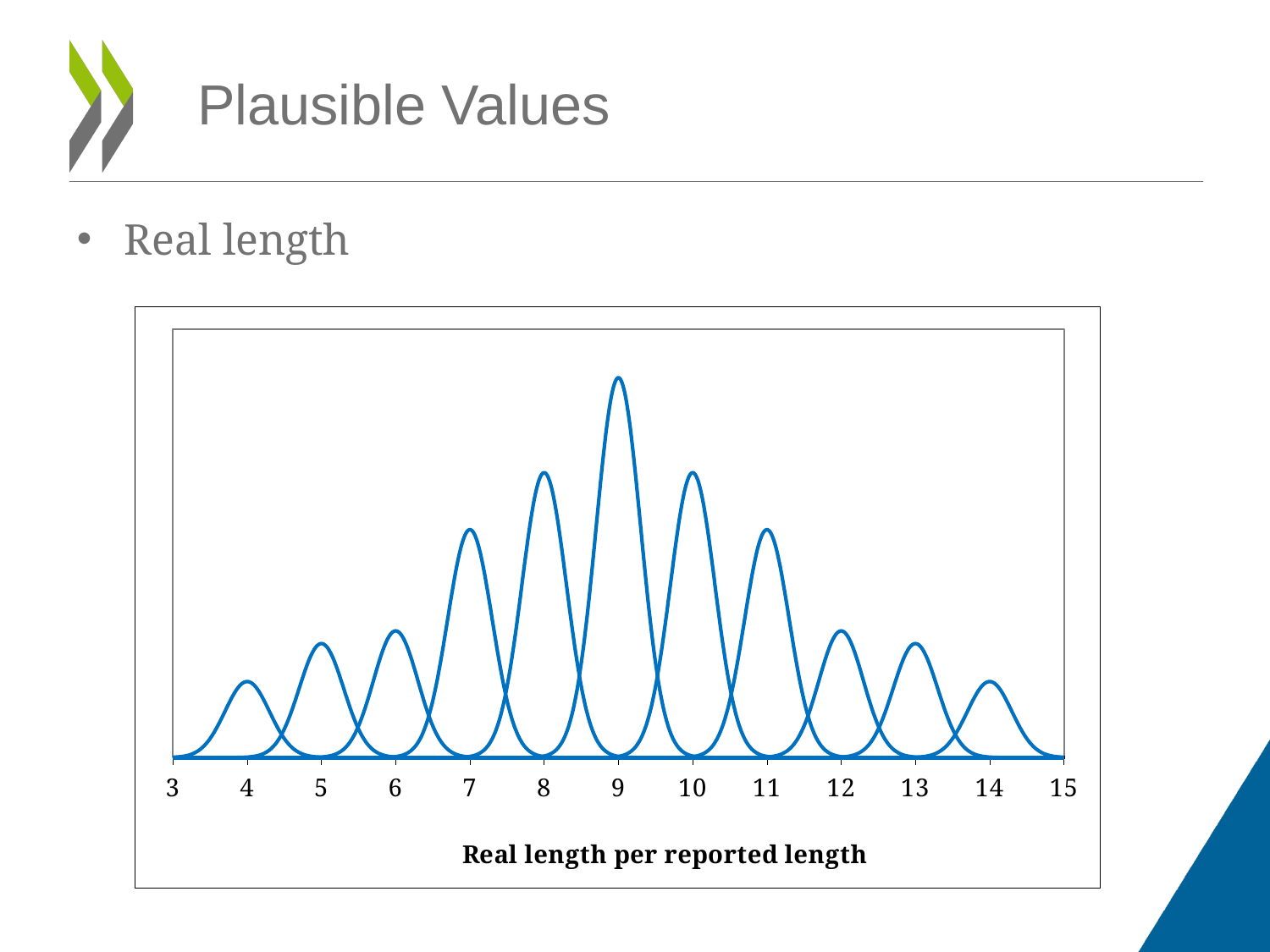
What kind of chart is shown on the slide? line chart Which curve has the higher peak, the one centred at 9 or the one centred at 10? 9 Do the peaks of the curves rise or fall as the x-axis goes from 4 to 9? rise Which curve has the higher peak, the one centred at 5 or the one centred at 7? 7 How many bell-shaped curves are plotted on the chart? 11 What is the x-axis title of the chart? Real length per reported length At which x-axis value is the tallest curve centred? 9 Which curve has the higher peak, the one centred at 11 or the one centred at 13? 11 What is the lowest value labelled on the x axis? 3 Do the peaks of the curves rise or fall as the x-axis goes from 9 to 14? fall